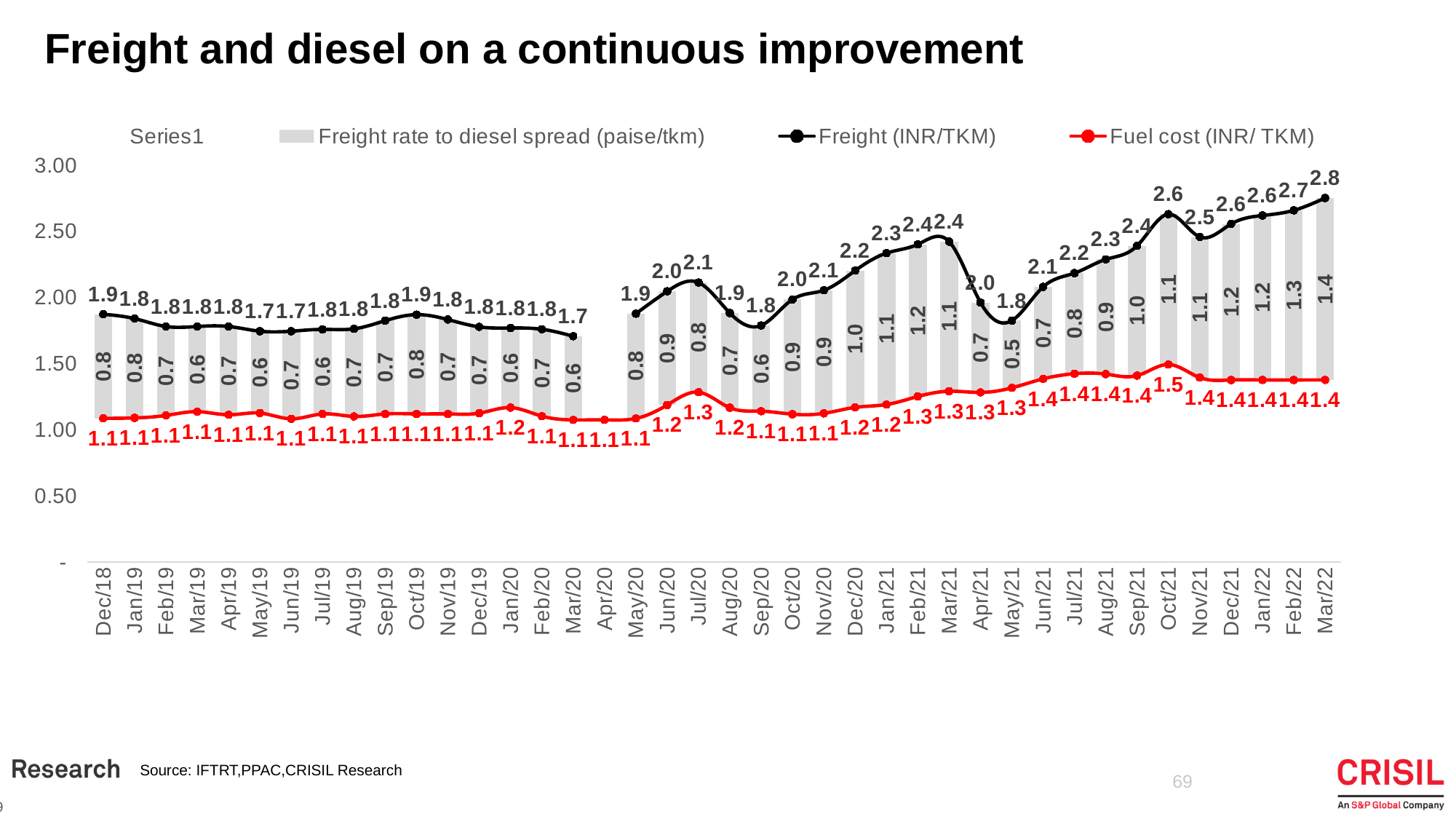
Is the Freight (INR/TKM) value for Mar/22 greater or less than 2.50? greater In which month is the Fuel cost (INR/ TKM) highest? Oct/21 In which month is the Freight rate to diesel spread (paise/tkm) lowest? May/21 What is the Fuel cost (INR/ TKM) value for Oct/21? 1.5 What is the Freight rate to diesel spread (paise/tkm) value for Feb/21? 1.2 In which month is the Freight (INR/TKM) value highest? Mar/22 How many entries does the legend list? 4 Which month has the higher Freight (INR/TKM) value, Jul/20 or Sep/20? Jul/20 What kind of chart is shown on the slide? Combined bar and line chart By how much does the Freight (INR/TKM) value for Mar/22 exceed the value for Dec/18? 0.9 What is the Freight (INR/TKM) value for Mar/22? 2.8 Does the Freight (INR/TKM) line rise or fall from Jun/21 to Mar/22? Rises